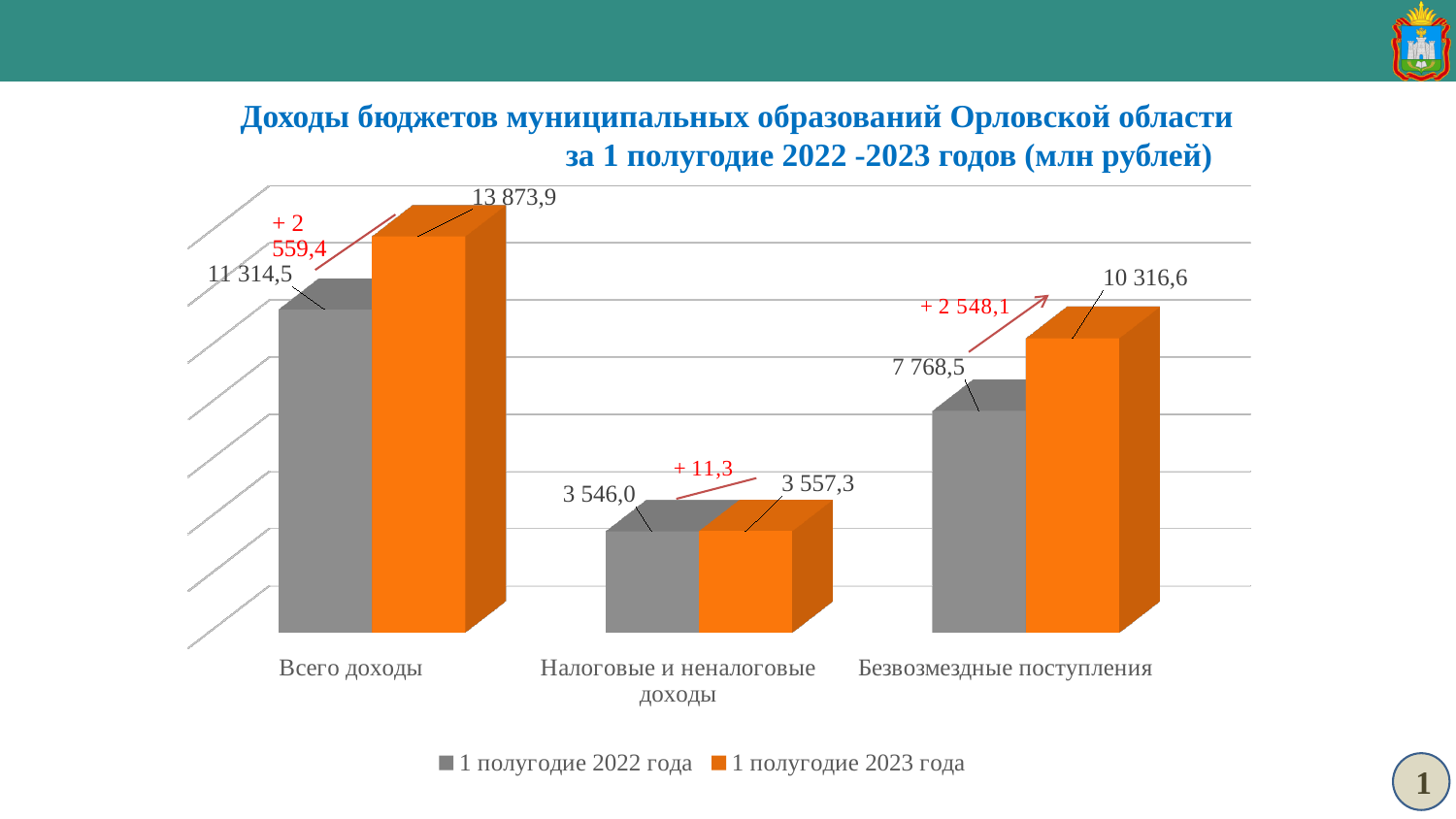
What kind of chart is shown on the slide? Bar chart What is the difference between the 2023 and 2022 values for Всего доходы? 2 559,4 Which category has the highest value in 1 полугодие 2023 года? Всего доходы What is the value for Всего доходы in 1 полугодие 2023 года? 13 873,9 What is the value for Налоговые и неналоговые доходы in 1 полугодие 2023 года? 3 557,3 Which category has the lowest value in 1 полугодие 2022 года? Налоговые и неналоговые доходы How many series does the legend list? 2 What is the difference between the 2023 and 2022 values for Безвозмездные поступления? 2 548,1 What is the value for Безвозмездные поступления in 1 полугодие 2022 года? 7 768,5 What is the value for Всего доходы in 1 полугодие 2022 года? 11 314,5 Which is larger: Безвозмездные поступления in 1 полугодие 2023 года or Всего доходы in 1 полугодие 2022 года? Всего доходы in 1 полугодие 2022 года How many categories are shown on the x axis? 3